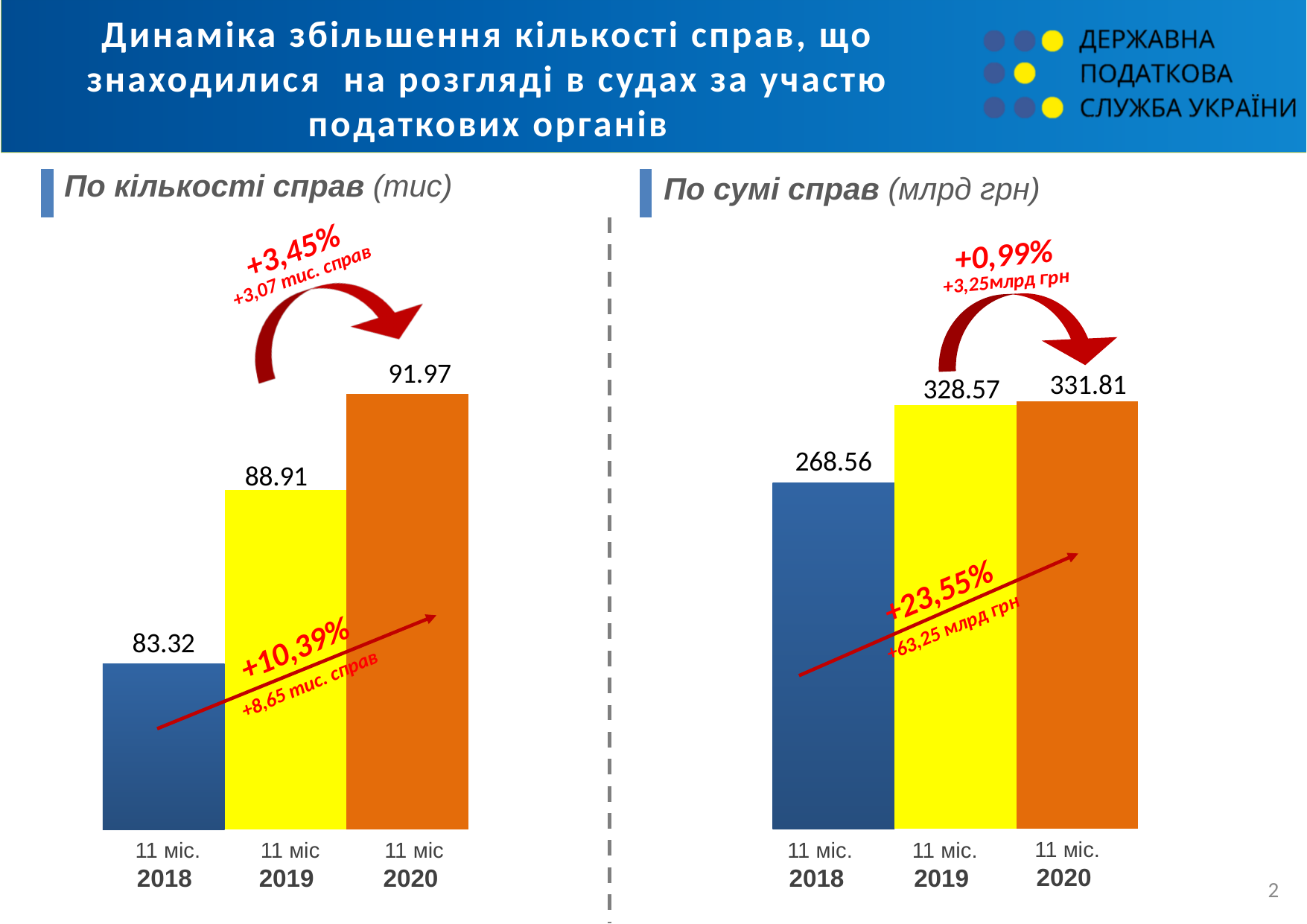
What type of chart is used on the right side of the slide, 'По сумі справ (млрд грн)'? Bar chart How many bars are shown in the chart 'По кількості справ (тис)'? 3 In the chart 'По кількості справ (тис)', what is the value for 11 міс. 2018? 83.32 In the chart 'По кількості справ (тис)', do the values rise or fall from 2018 to 2020? Rise In the chart 'По сумі справ (млрд грн)', what is the value for 11 міс. 2018? 268.56 In the chart 'По сумі справ (млрд грн)', which year has the lowest value? 2018 In the chart 'По кількості справ (тис)', which year has the highest value? 2020 In the chart 'По кількості справ (тис)', what is the difference between the values for 11 міс. 2019 and 11 міс. 2018? 5.59 In the chart 'По кількості справ (тис)', what is the value for 11 міс. 2020? 91.97 In the chart 'По сумі справ (млрд грн)', what is the difference between the values for 11 міс. 2020 and 11 міс. 2019? 3.24 In the chart 'По сумі справ (млрд грн)', what is the value for 11 міс. 2019? 328.57 In the chart 'По сумі справ (млрд грн)', which is larger: the value for 11 міс. 2018 or 11 міс. 2019? 11 міс. 2019